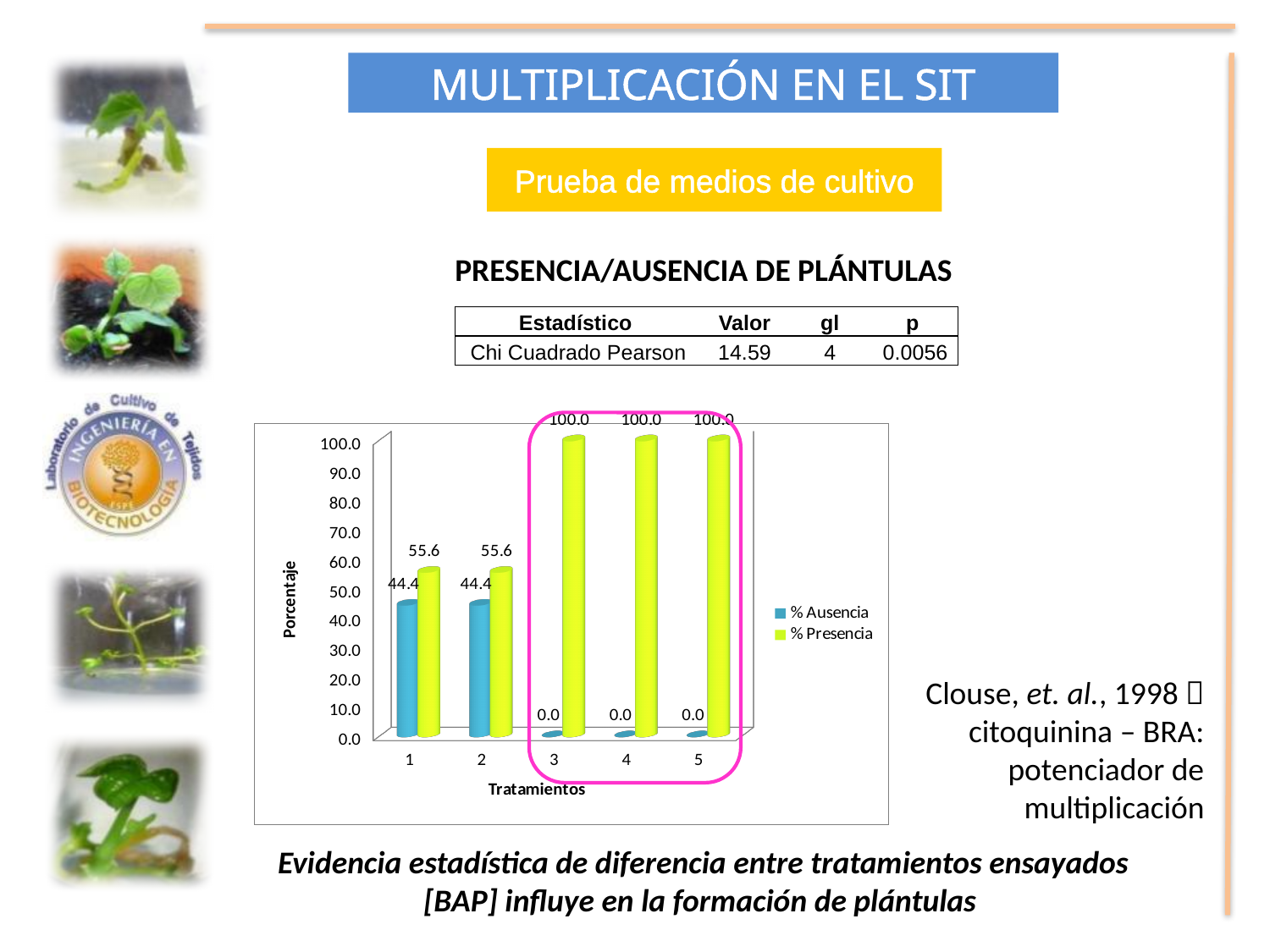
What is the label of the y axis of the chart? Porcentaje What is the difference in % Presencia between treatment 3 and treatment 2? 44.4 How many treatments are shown on the x axis of the chart? 5 For treatment 2, which is larger: % Ausencia or % Presencia? % Presencia What is the % Presencia value for treatment 2? 55.6 What is the difference between the % Presencia and % Ausencia values for treatment 1? 11.2 What is the % Ausencia value for treatment 4? 0.0 What kind of chart is shown on the slide? Bar chart What is the % Ausencia value for treatment 1? 44.4 What is the % Presencia value for treatment 3? 100.0 Which treatment has the lowest % Presencia value? Treatments 1 and 2 (55.6) How many series does the chart legend list? 2